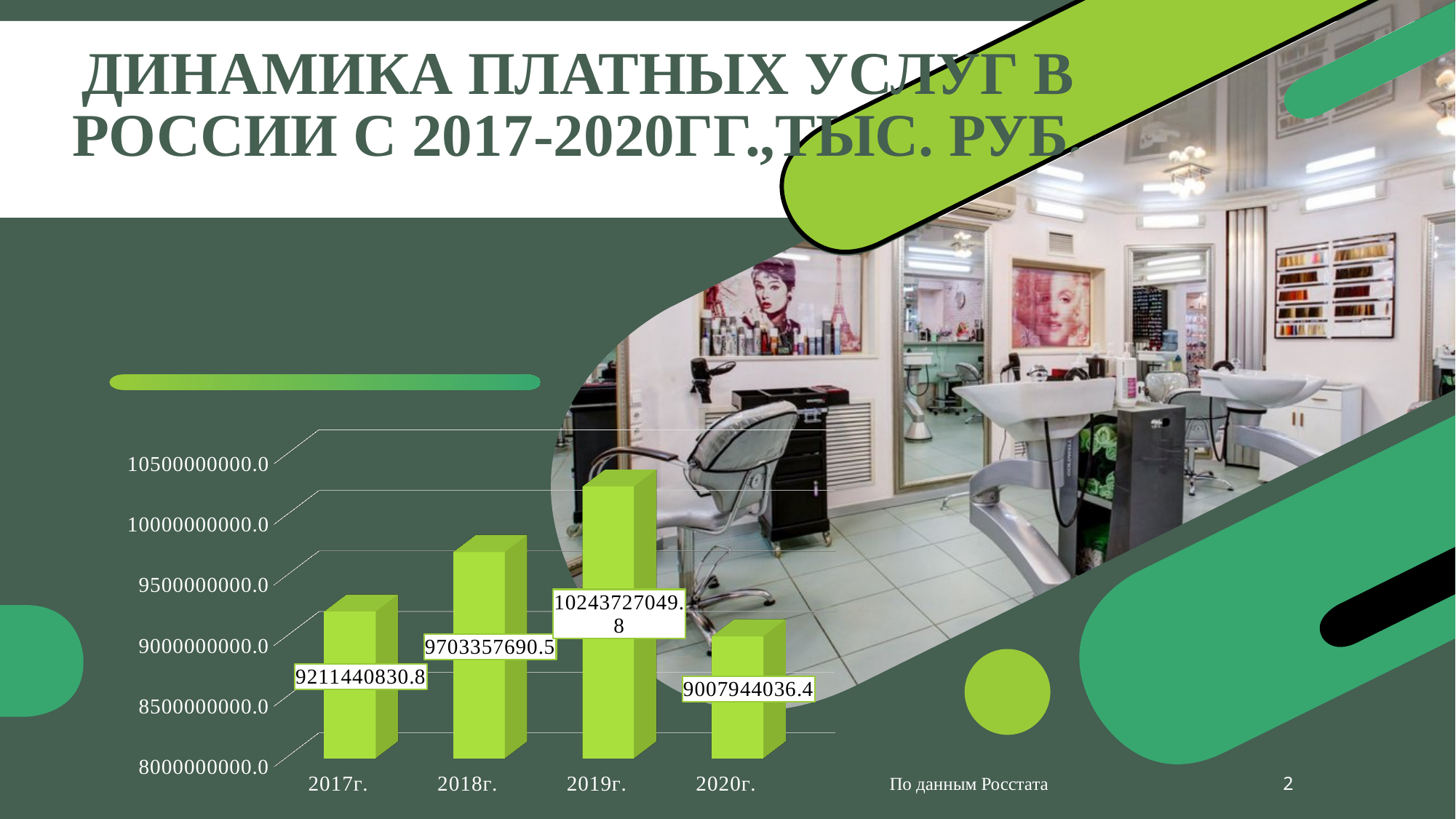
What is the value for 2017г.? 9211440830.8 Which is larger, the value for 2018г. or the value for 2020г.? 2018г. Is the value for 2020г. greater or less than 9500000000.0? less Which year has the highest value? 2019г. What kind of chart is shown on the slide? bar chart What is the difference between the values for 2019г. and 2018г.? 540369359.3 What is the difference between the values for 2017г. and 2020г.? 203496794.4 How many years are shown on the chart? 4 What is the value for 2018г.? 9703357690.5 What is the value for 2019г.? 10243727049.8 What is the value for 2020г.? 9007944036.4 Which year has the lowest value? 2020г.